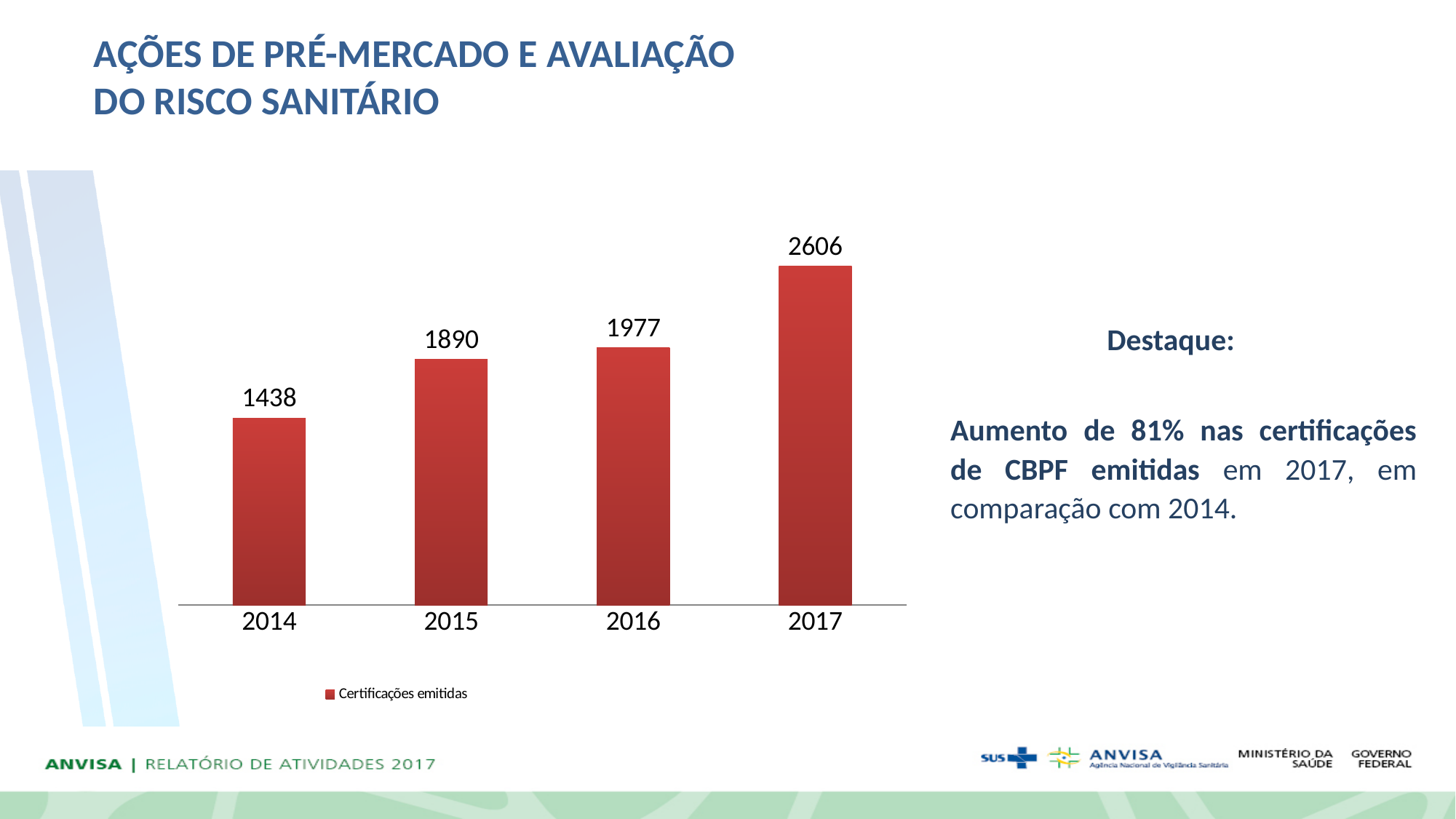
What is the value for 2017? 2606 Which year has the lowest value? 2014 What is the difference between the values for 2017 and 2014? 1168 What is the difference between the values for 2016 and 2015? 87 What is the value for 2014? 1438 Which year has the highest value? 2017 What is the value for 2016? 1977 Which is larger, the value for 2015 or the value for 2017? 2017 How many years are shown on the x axis? 4 What kind of chart is shown on the slide? bar chart What is the value for 2015? 1890 Do the values rise or fall from 2014 to 2017? rise